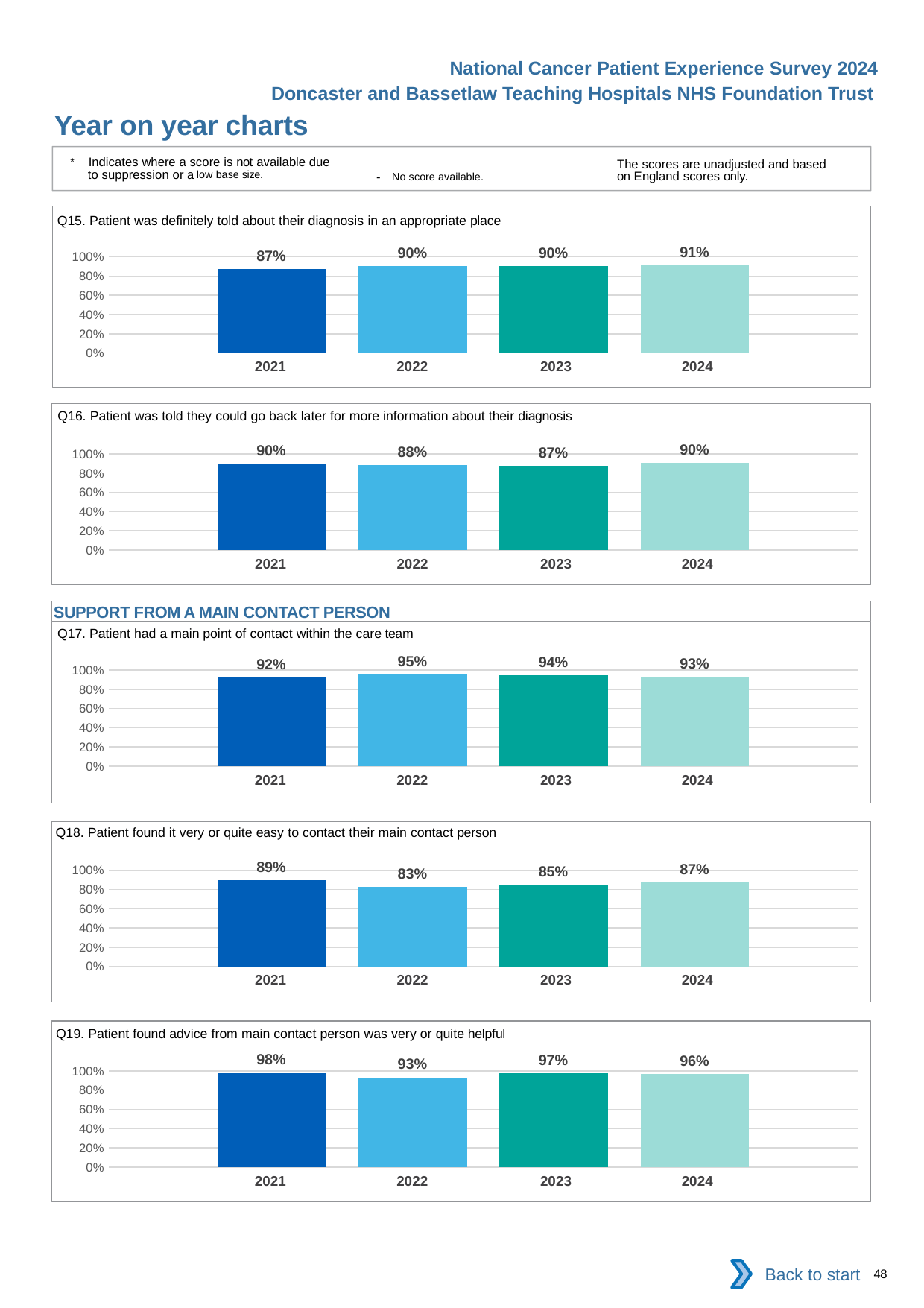
In the Q18 chart (Patient found it very or quite easy to contact their main contact person), which year has the lowest value? 2022 In the Q19 chart, what is the value for 2023? 97% In the Q15 chart, which year has the highest value? 2024 In the Q16 chart (Patient was told they could go back later for more information about their diagnosis), what is the value for 2023? 87% In the Q17 chart (Patient had a main point of contact within the care team), which year has the highest value? 2022 What kind of chart is the Q18 chart? Bar chart How many years are shown on the x axis of the Q15 chart? 4 In the Q15 chart (Patient was definitely told about their diagnosis in an appropriate place), what is the value for 2021? 87% In the Q16 chart, what is the difference between the 2021 and 2023 values? 3 percentage points In the Q17 chart, what is the value for 2024? 93% In the Q19 chart (Patient found advice from main contact person was very or quite helpful), which is larger: the value for 2021 or 2022? 2021 In the Q18 chart, what is the difference between the 2021 and 2022 values? 6 percentage points